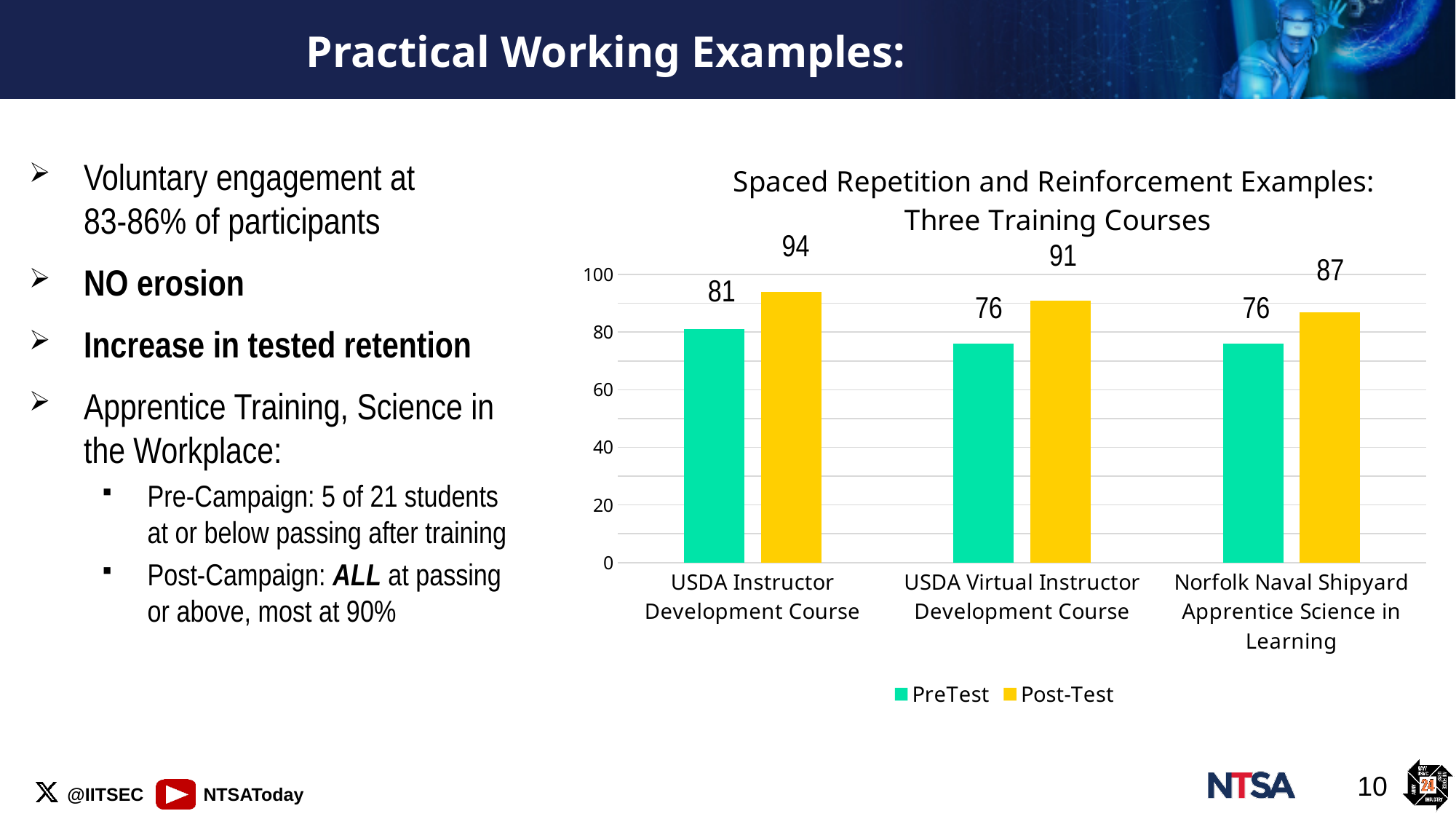
How many training courses are shown on the x axis? 3 How many series does the legend list? 2 What is the PreTest value for USDA Instructor Development Course? 81 What is the difference between the Post-Test and PreTest values for USDA Virtual Instructor Development Course? 15 What is the Post-Test value for Norfolk Naval Shipyard Apprentice Science in Learning? 87 What kind of chart is shown on the slide? Bar chart What is the Post-Test value for USDA Virtual Instructor Development Course? 91 What is the difference between the Post-Test and PreTest values for USDA Instructor Development Course? 13 Which course has the highest Post-Test value? USDA Instructor Development Course Is the PreTest value for USDA Virtual Instructor Development Course greater or less than 80? less Which course has the lowest Post-Test value? Norfolk Naval Shipyard Apprentice Science in Learning Which is larger for Norfolk Naval Shipyard Apprentice Science in Learning, the PreTest or the Post-Test value? Post-Test